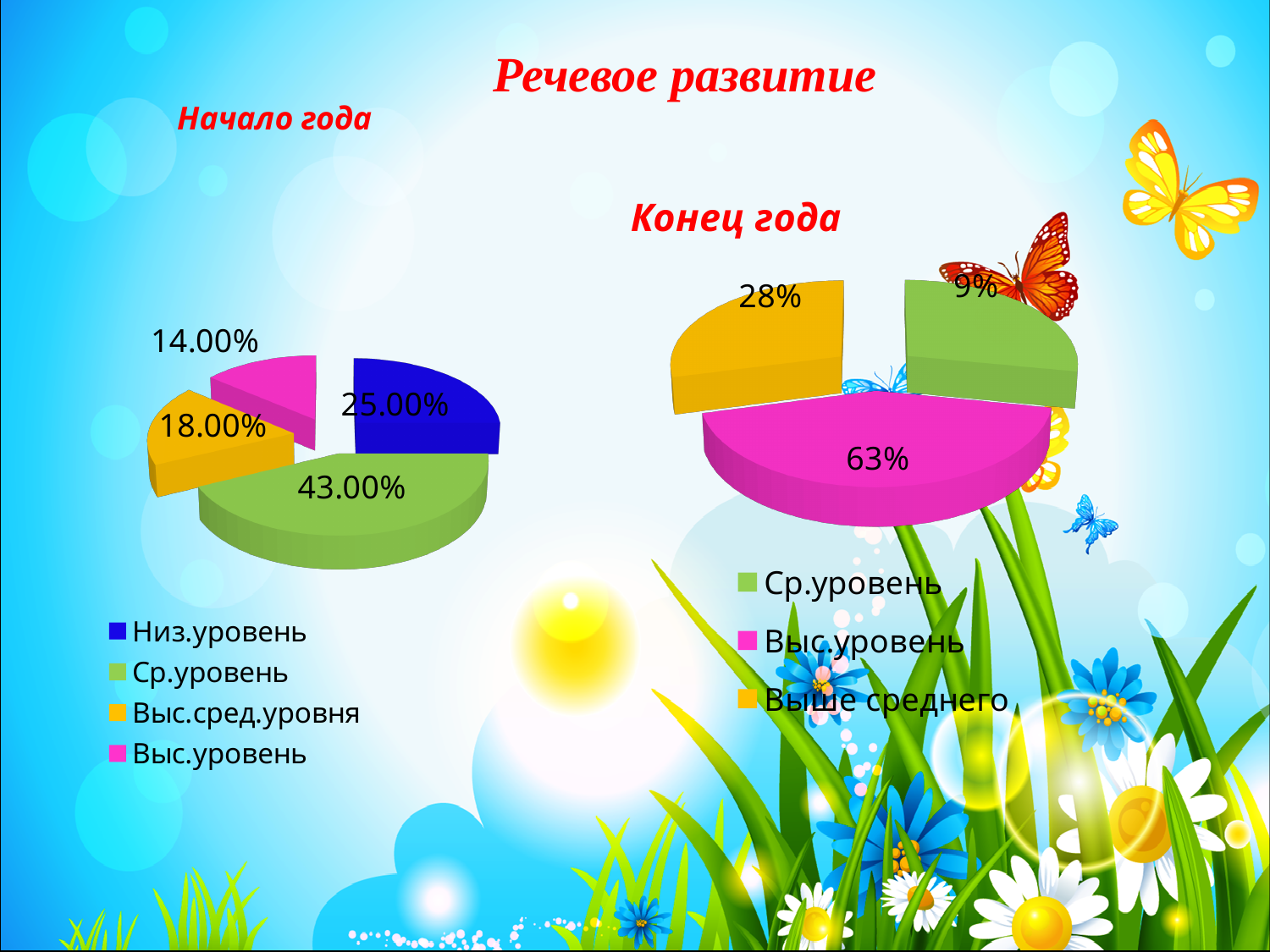
In the "Начало года" chart, what is the value for Низ.уровень? 25.00% In the "Начало года" chart, what is the difference between Ср.уровень and Выс.сред.уровня? 25.00% In the "Конец года" chart, which category has the largest share? Выс.уровень In the "Конец года" chart, what is the value for Выс.уровень? 63% In the "Начало года" chart, what is the value for Ср.уровень? 43.00% In the "Конец года" chart, what is the value for Выше среднего? 28% In the "Начало года" chart, which category has the smallest share? Выс.уровень In the "Конец года" chart, which is larger: Ср.уровень or Выше среднего? Выше среднего What is the main title of the slide above the two charts? Речевое развитие In the "Начало года" chart, how many categories does the legend list? 4 In the "Конец года" chart, what is the difference between Выс.уровень and Ср.уровень? 54% What type of chart is used for "Конец года"? Pie chart